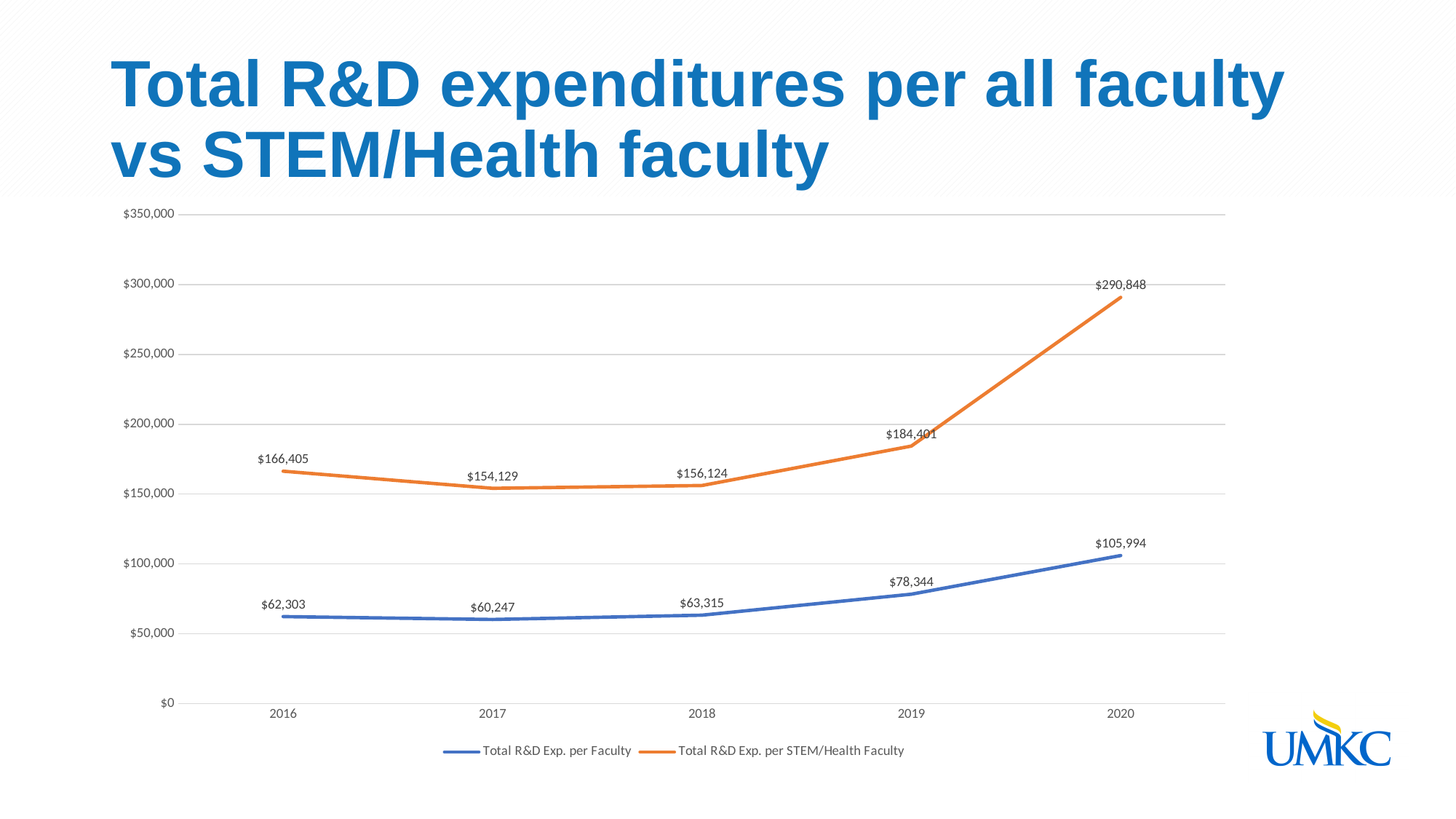
What is the Total R&D Exp. per STEM/Health Faculty value for 2020? $290,848 How many years are shown on the x axis? 5 Does Total R&D Exp. per STEM/Health Faculty rise or fall from 2018 to 2020? rise What kind of chart is shown on the slide? line chart Which is larger: Total R&D Exp. per Faculty in 2020 or Total R&D Exp. per STEM/Health Faculty in 2017? Total R&D Exp. per STEM/Health Faculty in 2017 How many series does the legend list? 2 In which year is Total R&D Exp. per STEM/Health Faculty highest? 2020 In which year is Total R&D Exp. per Faculty lowest? 2017 Is the Total R&D Exp. per Faculty value for 2020 greater or less than $100,000? greater What is the Total R&D Exp. per STEM/Health Faculty value for 2016? $166,405 What is the Total R&D Exp. per Faculty value for 2017? $60,247 What is the difference between Total R&D Exp. per STEM/Health Faculty and Total R&D Exp. per Faculty in 2019? $106,057